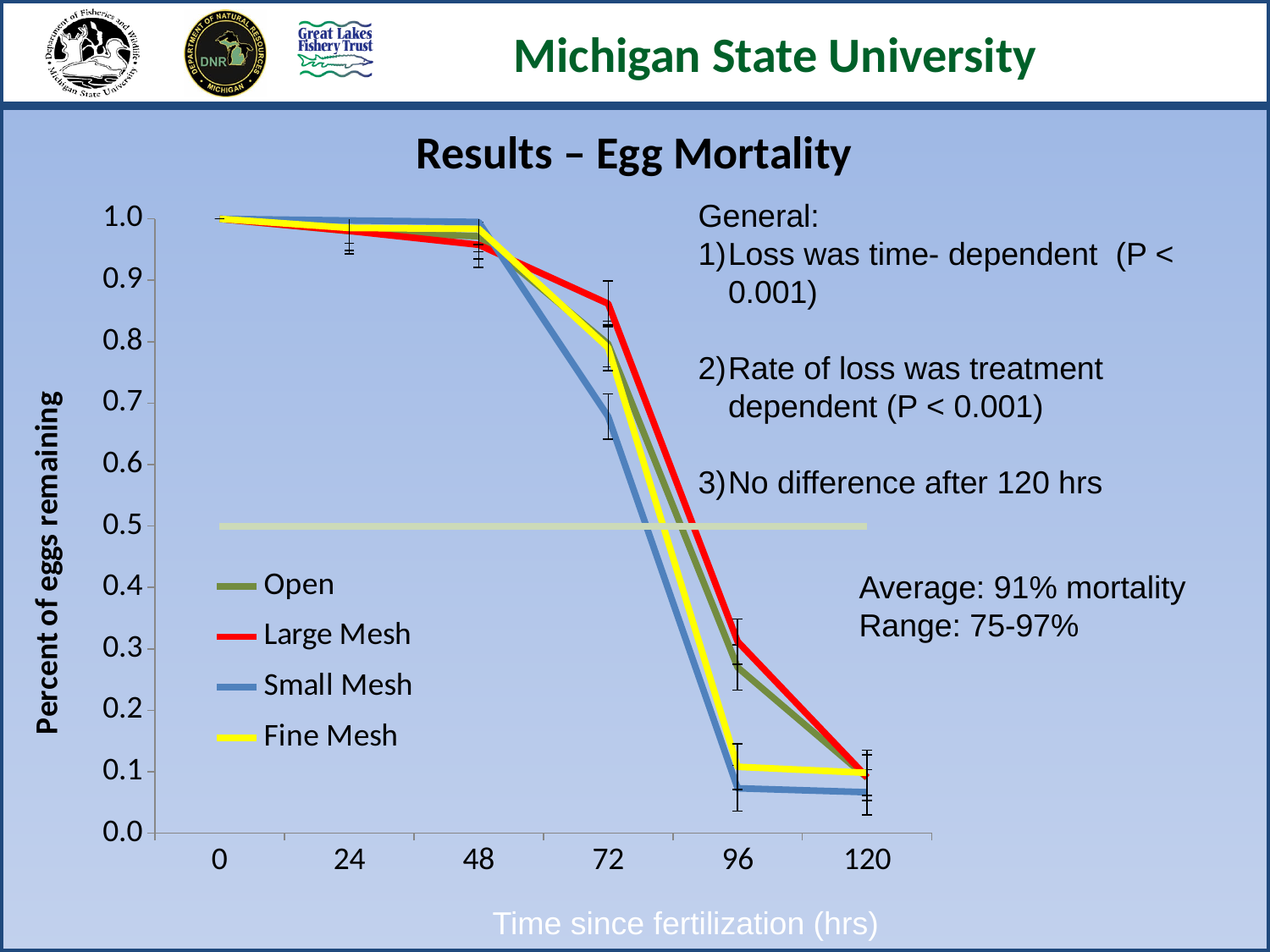
Is the value for Open at 96 hrs greater or less than 0.4? less At 96 hrs, which is larger: the value for Large Mesh or the value for Small Mesh? Large Mesh What kind of chart is shown on the slide? Line chart At 72 hrs, which series has the lowest percent of eggs remaining? Small Mesh How many time points are labelled on the x axis? 6 Is the value for Large Mesh at 72 hrs greater or less than 0.8? greater Is the value for Large Mesh at 96 hrs greater or less than 0.5? less How many series does the legend list? 4 What is the title of the y axis? Percent of eggs remaining At 72 hrs, which series has the highest percent of eggs remaining? Large Mesh Do the values for Small Mesh rise or fall as time since fertilization increases? Fall